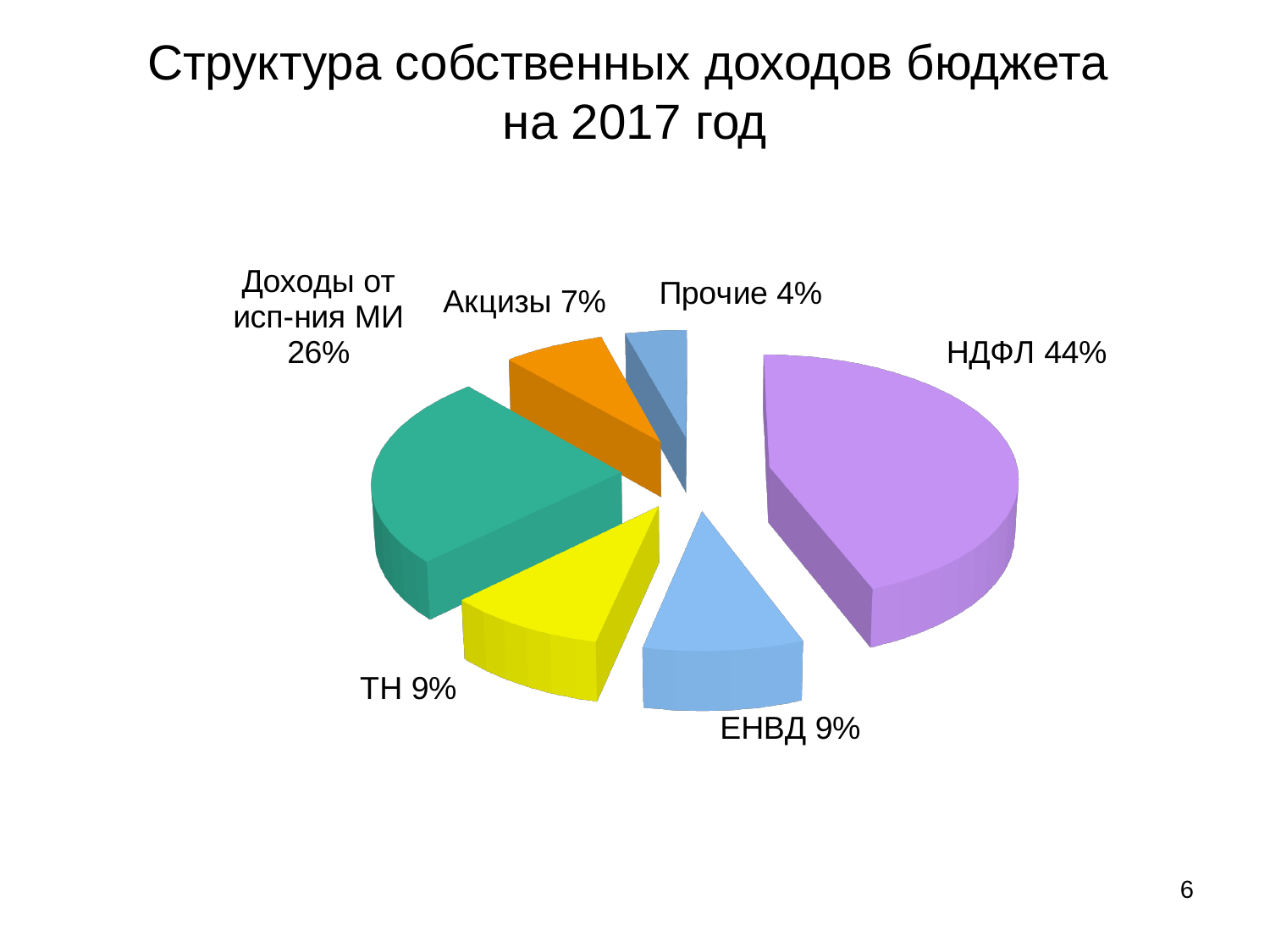
What share of the budget's own revenues does НДФЛ account for? 44% What is the difference in percentage points between НДФЛ and Доходы от исп-ния МИ? 18 What kind of chart is shown on the slide? pie chart What percentage is shown for Доходы от исп-ния МИ? 26% What percentage is shown for Прочие? 4% What is the title of the chart on the slide? Структура собственных доходов бюджета на 2017 год Which category has the smallest share of the pie? Прочие Which category has the largest share of the pie? НДФЛ What is the combined share of ТН and ЕНВД? 18% Which is larger, the share for Акцизы or the share for Прочие? Акцизы How many slices does the pie chart have? 6 What percentage is shown for Акцизы? 7%